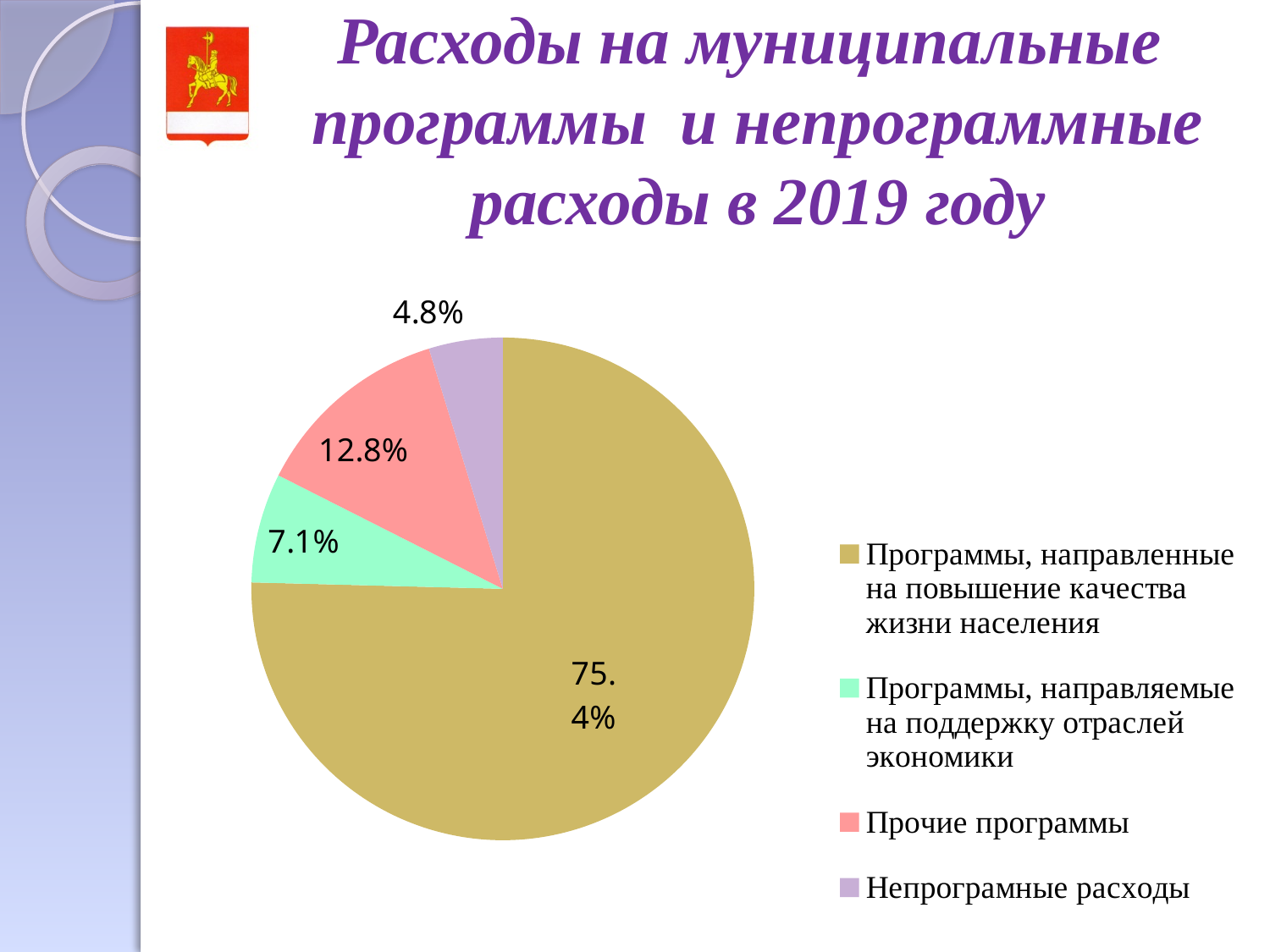
What is the title of the chart on the slide? Расходы на муниципальные программы и непрограммные расходы в 2019 году What type of chart is shown on the slide? pie chart What share of the pie is labelled for "Программы, направляемые на поддержку отраслей экономики"? 7.1% What is the difference in percentage points between the "Прочие программы" slice and the "Непрограмные расходы" slice? 8 percentage points Which category has the smallest slice of the pie? Непрограмные расходы Which category has the largest slice of the pie? Программы, направленные на повышение качества жизни населения What colour is the slice for "Прочие программы"? pink Which is larger: the slice for "Прочие программы" or the slice for "Программы, направляемые на поддержку отраслей экономики"? Прочие программы What share of the pie is labelled for "Непрограмные расходы"? 4.8% How many slices does the pie chart have? 4 What share of the pie is labelled for "Прочие программы"? 12.8% What share of the pie is labelled for "Программы, направленные на повышение качества жизни населения"? 75.4%